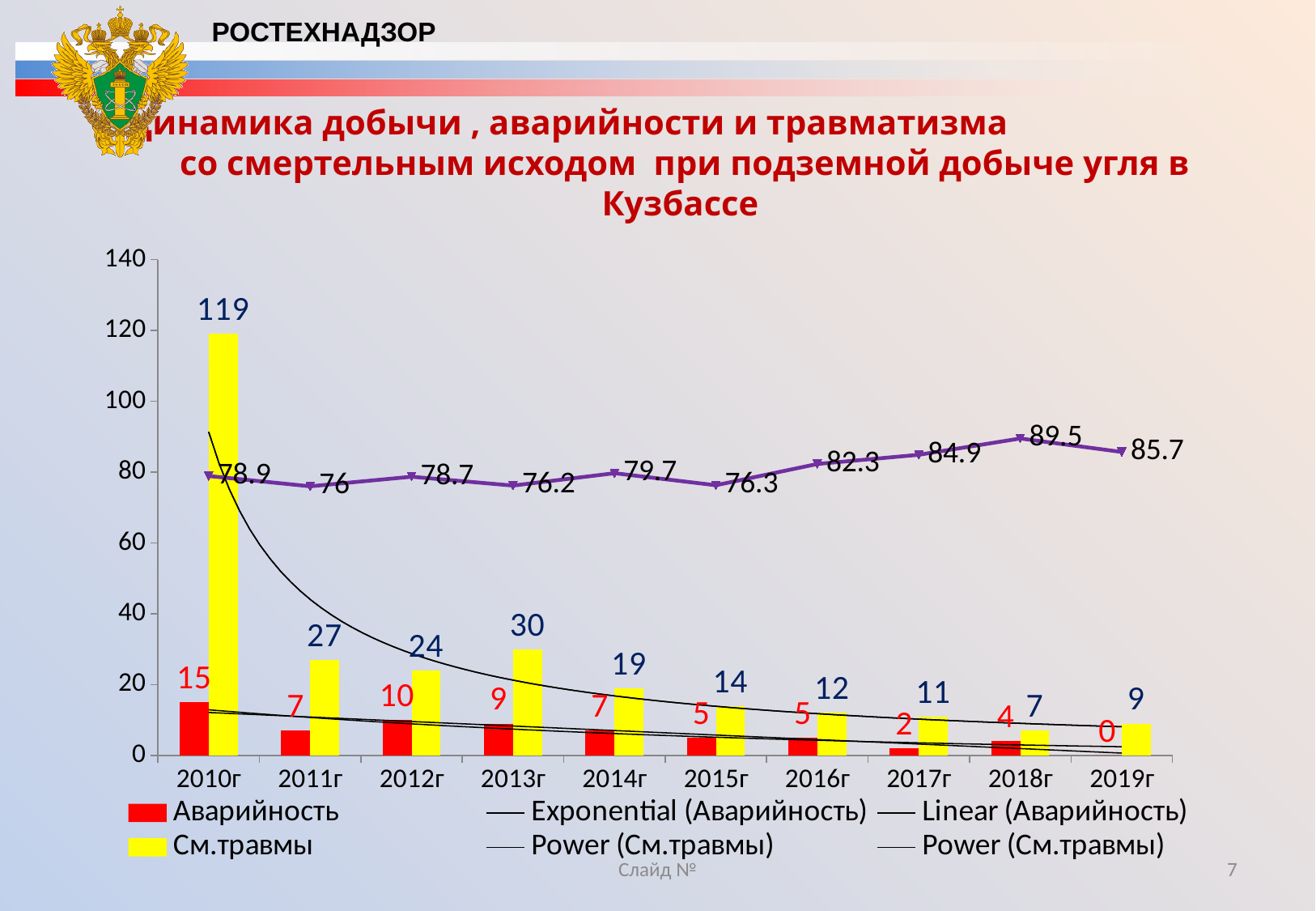
In which year is Аварийность lowest? 2019г How many entries does the legend list? 6 What colour are the Аварийность bars? red How many years are shown on the x axis? 10 Does См.травмы generally rise or fall from 2010г to 2019г? fall What is the value of Аварийность for 2012г? 10 What is the value of См.травмы for 2010г? 119 What value does the purple line show for 2018г? 89.5 Which is larger: Аварийность in 2011г or Аварийность in 2013г? 2013г Is the value of the purple line for 2016г greater or less than 80? greater In which year is См.травмы highest? 2010г What is the difference between См.травмы in 2013г and in 2014г? 11